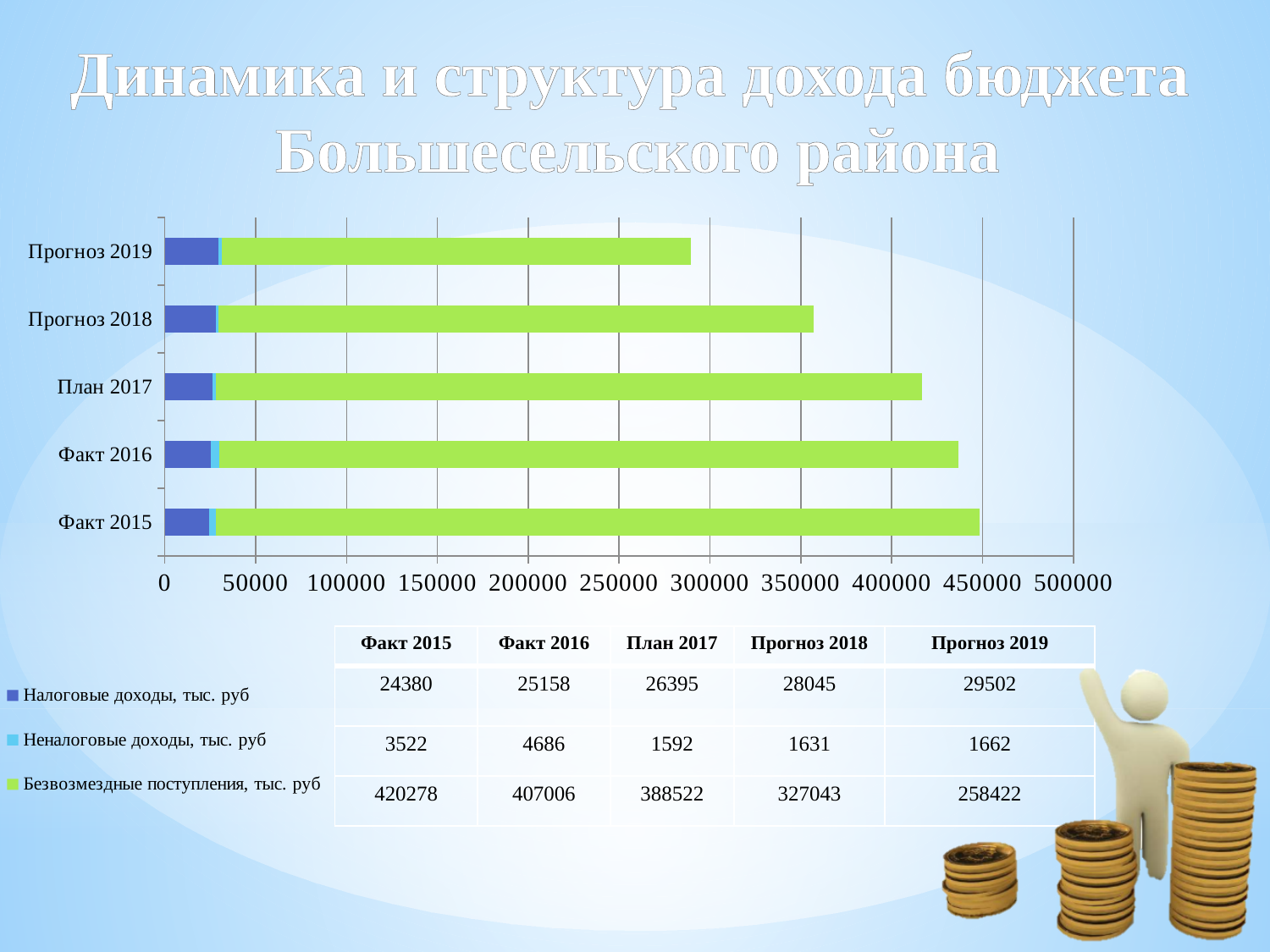
Which is larger: Налоговые доходы for Прогноз 2018 or for План 2017? Прогноз 2018 How many categories (years) are plotted on the chart? 5 Do the total bar lengths rise or fall from Факт 2015 to Прогноз 2019? Fall Which category has the highest value of Безвозмездные поступления? Факт 2015 Which category has the lowest value of Неналоговые доходы? План 2017 What is the value of Неналоговые доходы for Факт 2016? 4686 What type of chart is shown on the slide? Stacked bar chart What is the value of Налоговые доходы for Факт 2015? 24380 How many series does the legend list? 3 What is the difference between Безвозмездные поступления for Факт 2015 and Прогноз 2019? 161856 What is the total of the stacked bar for Факт 2015? 448180 What is the value of Безвозмездные поступления for Прогноз 2019? 258422